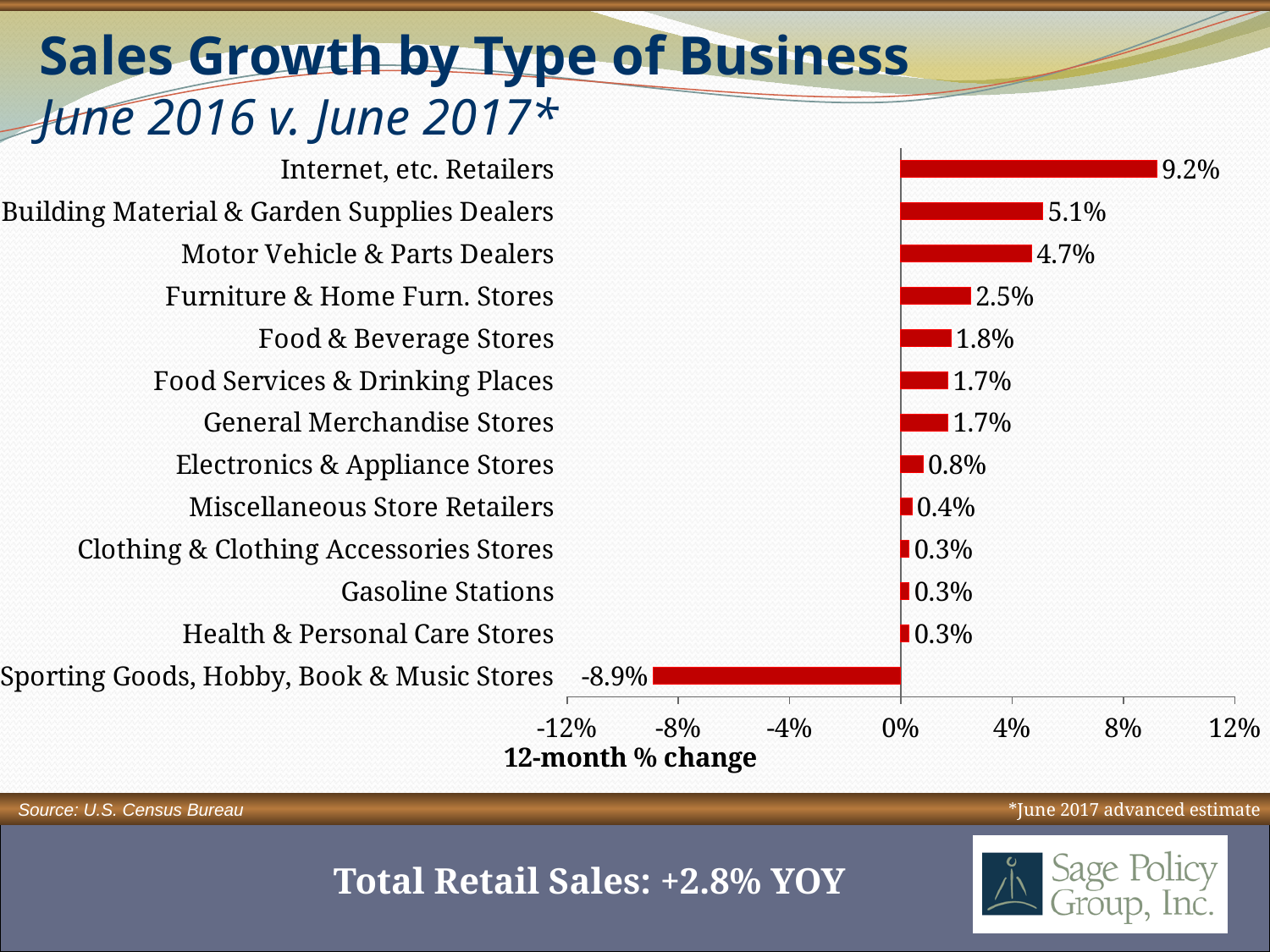
Which type of business has the highest 12-month % change? Internet, etc. Retailers Which type of business has the lowest 12-month % change? Sporting Goods, Hobby, Book & Music Stores What is the title of the chart on the slide? Sales Growth by Type of Business What kind of chart is shown on the slide? Bar chart What is the 12-month % change for Motor Vehicle & Parts Dealers? 4.7% How many types of business are shown in the chart? 13 What is the label of the horizontal axis of the chart? 12-month % change Which has a larger 12-month % change, Furniture & Home Furn. Stores or Food & Beverage Stores? Furniture & Home Furn. Stores Is the value for Internet, etc. Retailers greater or less than 8%? greater What is the difference between the 12-month % change for Building Material & Garden Supplies Dealers and Motor Vehicle & Parts Dealers? 0.4% What is the 12-month % change for Sporting Goods, Hobby, Book & Music Stores? -8.9% What is the 12-month % change for Internet, etc. Retailers? 9.2%